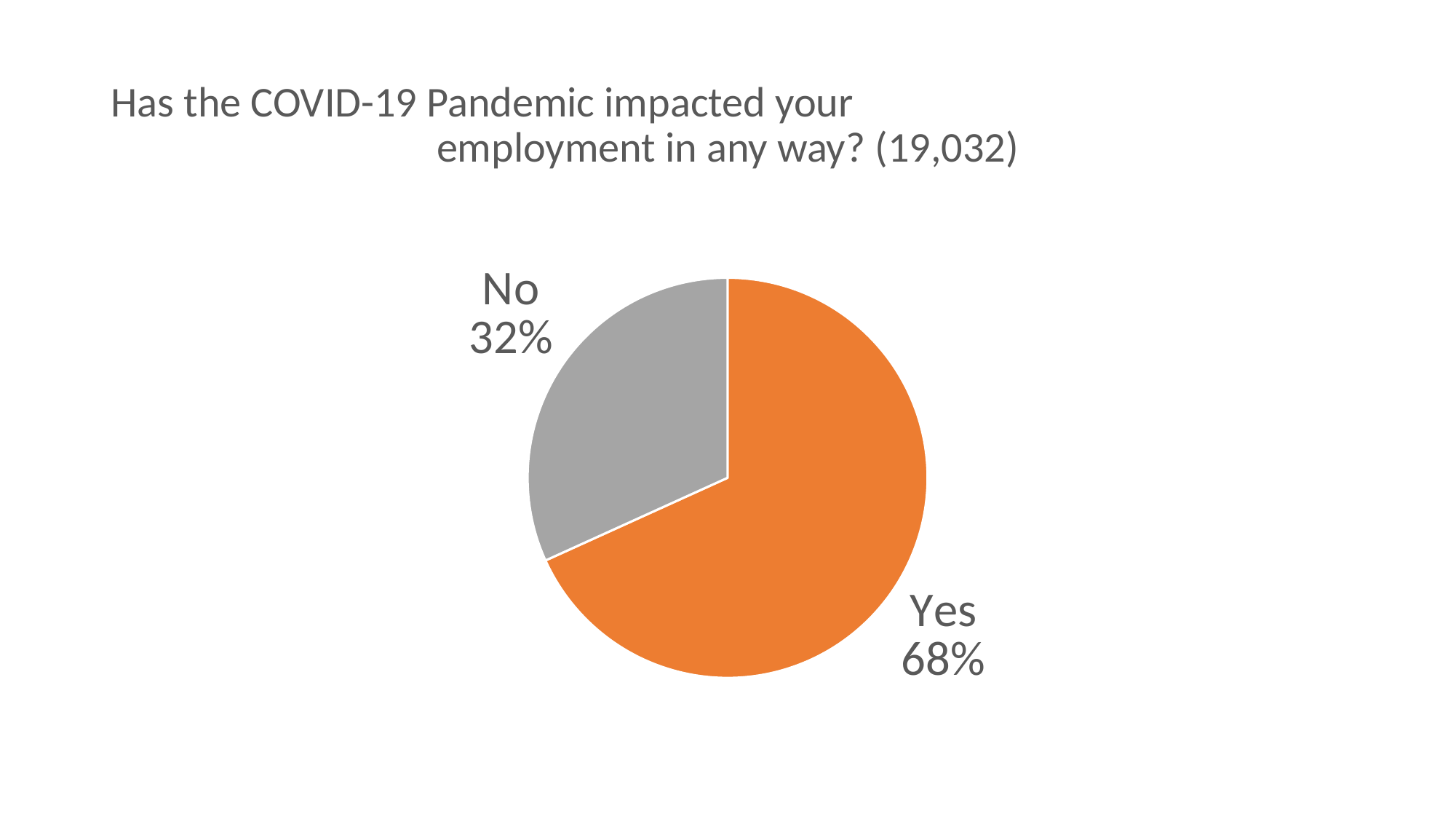
What share of the pie does the "No" slice represent? 32% What kind of chart is shown on the slide? pie chart What colour is the "Yes" slice? orange How many responses does the chart title indicate were collected? 19,032 What percentage of respondents answered "No"? 32% How many slices does the pie chart have? 2 Which response has the smallest share of the pie? No What is the difference in percentage points between the "Yes" and "No" slices? 36 Which slice is larger, "Yes" or "No"? Yes Which response has the largest share of the pie? Yes What is the title of the chart? Has the COVID-19 Pandemic impacted your employment in any way? (19,032) What percentage of respondents answered "Yes"? 68%